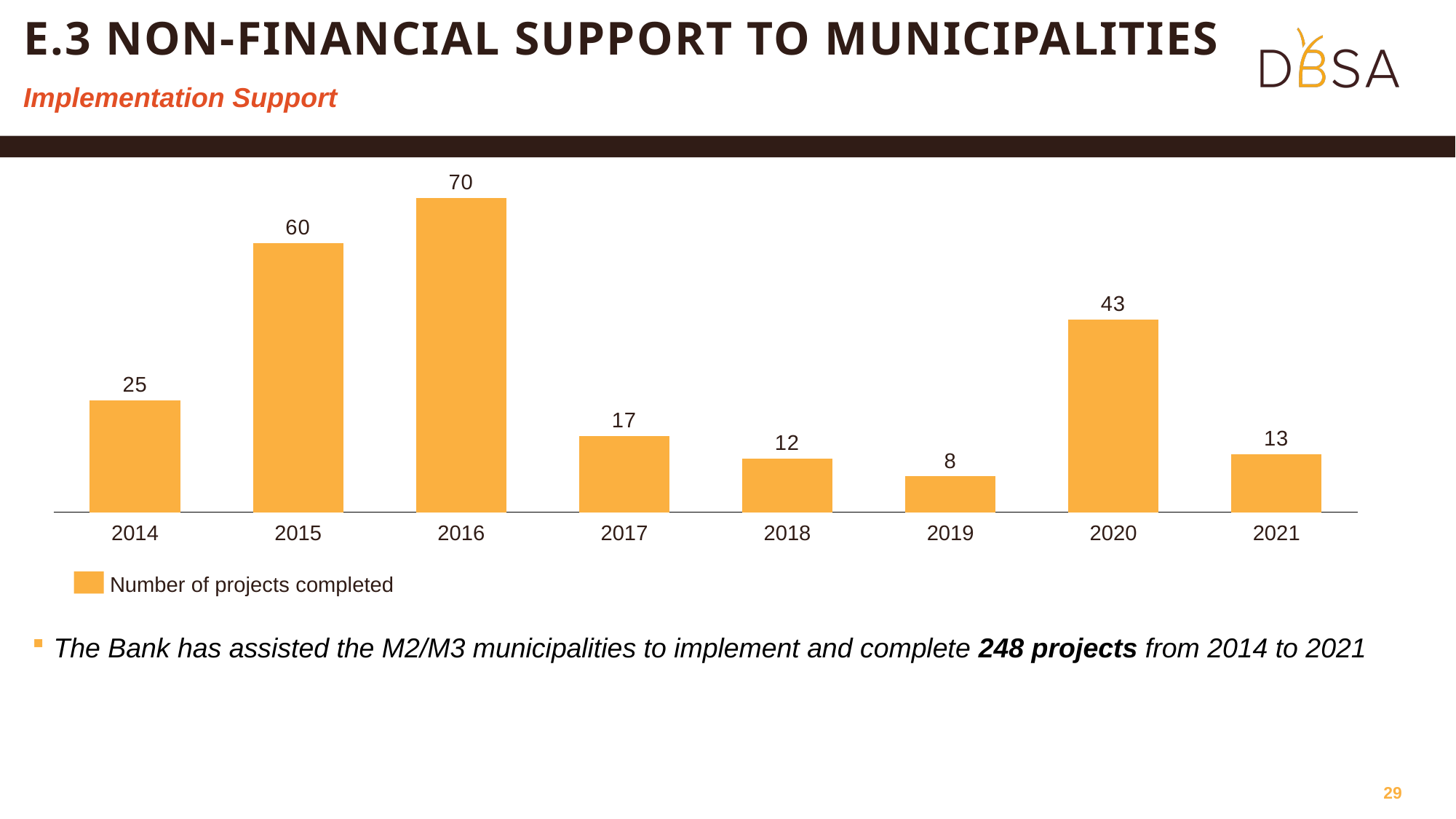
Which year has the lowest number of projects completed? 2019 What is the difference between the number of projects completed in 2016 and in 2015? 10 How many series does the chart legend list? 1 How many years are shown on the x axis of the chart? 8 What type of chart is shown on the slide? Bar chart How many projects were completed in 2016? 70 Which year had more projects completed, 2017 or 2018? 2017 Which year has the highest number of projects completed? 2016 How many more projects were completed in 2020 than in 2021? 30 What is the legend entry for the series shown in the chart? Number of projects completed What is the number of projects completed in 2020? 43 How many projects were completed in 2019? 8